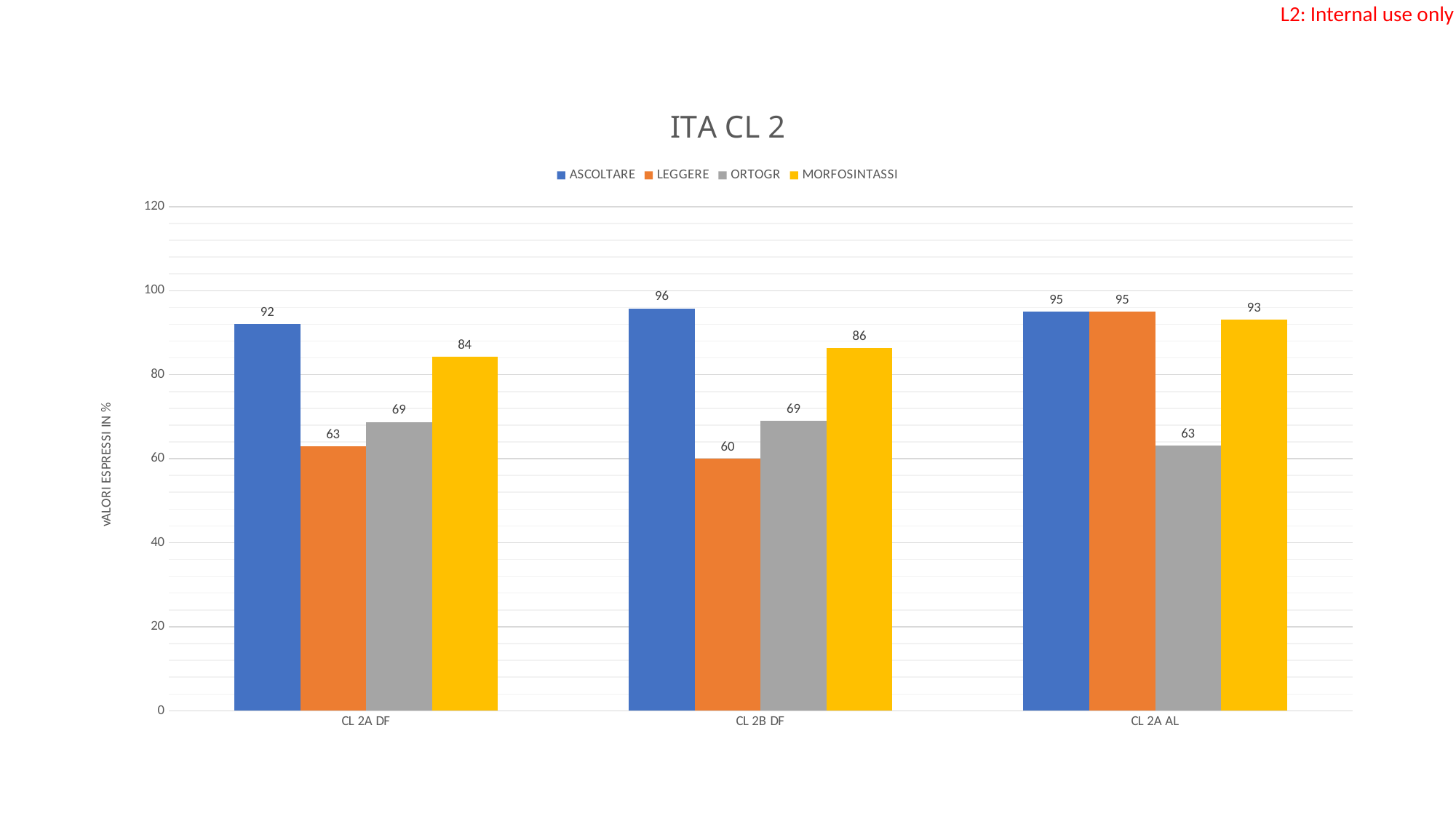
Which category has the lowest LEGGERE value? CL 2B DF What is the LEGGERE value for CL 2A AL? 95 What is the difference between the ASCOLTARE and LEGGERE values for CL 2B DF? 36 What kind of chart is shown on the slide? Bar chart How many series does the legend list? 4 What is the MORFOSINTASSI value for CL 2A DF? 84 What is the ASCOLTARE value for CL 2B DF? 96 What is the ORTOGR value for CL 2A AL? 63 Which is larger for CL 2A DF: the ORTOGR value or the MORFOSINTASSI value? MORFOSINTASSI What is the title of the chart? ITA CL 2 How many categories are shown on the x axis? 3 Which category has the highest MORFOSINTASSI value? CL 2A AL